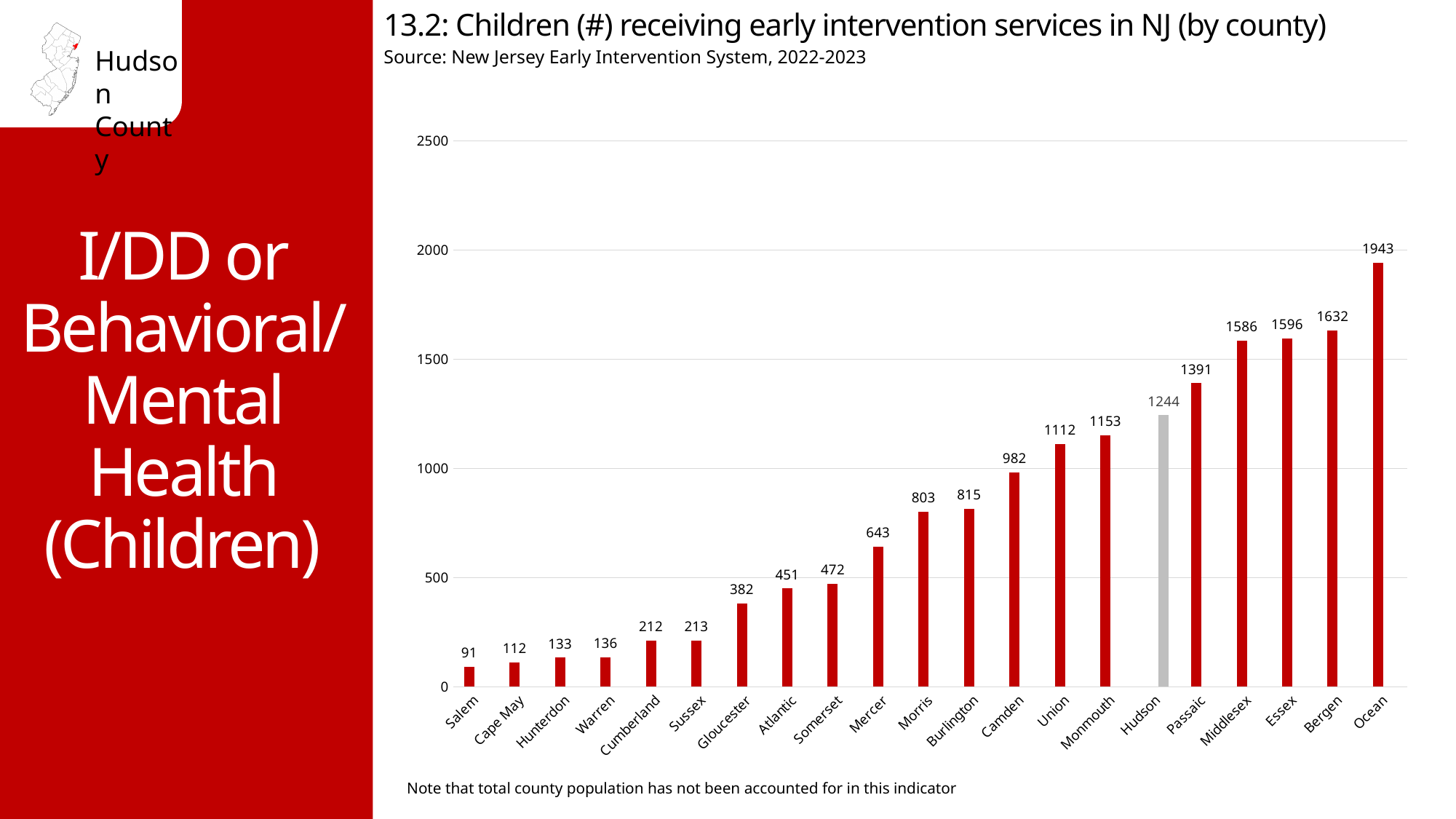
Which has a higher value, Passaic or Monmouth? Passaic Which county has the lowest number of children receiving early intervention services? Salem What is the value shown for Camden? 982 Do the values rise or fall moving from left to right along the x axis? Rise What kind of chart is this? Bar chart Which county's bar is shown in grey rather than red? Hudson Is the value for Union greater or less than 1000? greater What is the difference between the values for Ocean and Hudson? 699 What is the difference between the values for Bergen and Essex? 36 How many children are receiving early intervention services in Hudson County? 1244 How many counties are shown on the x axis? 21 Which county has the highest number of children receiving early intervention services? Ocean